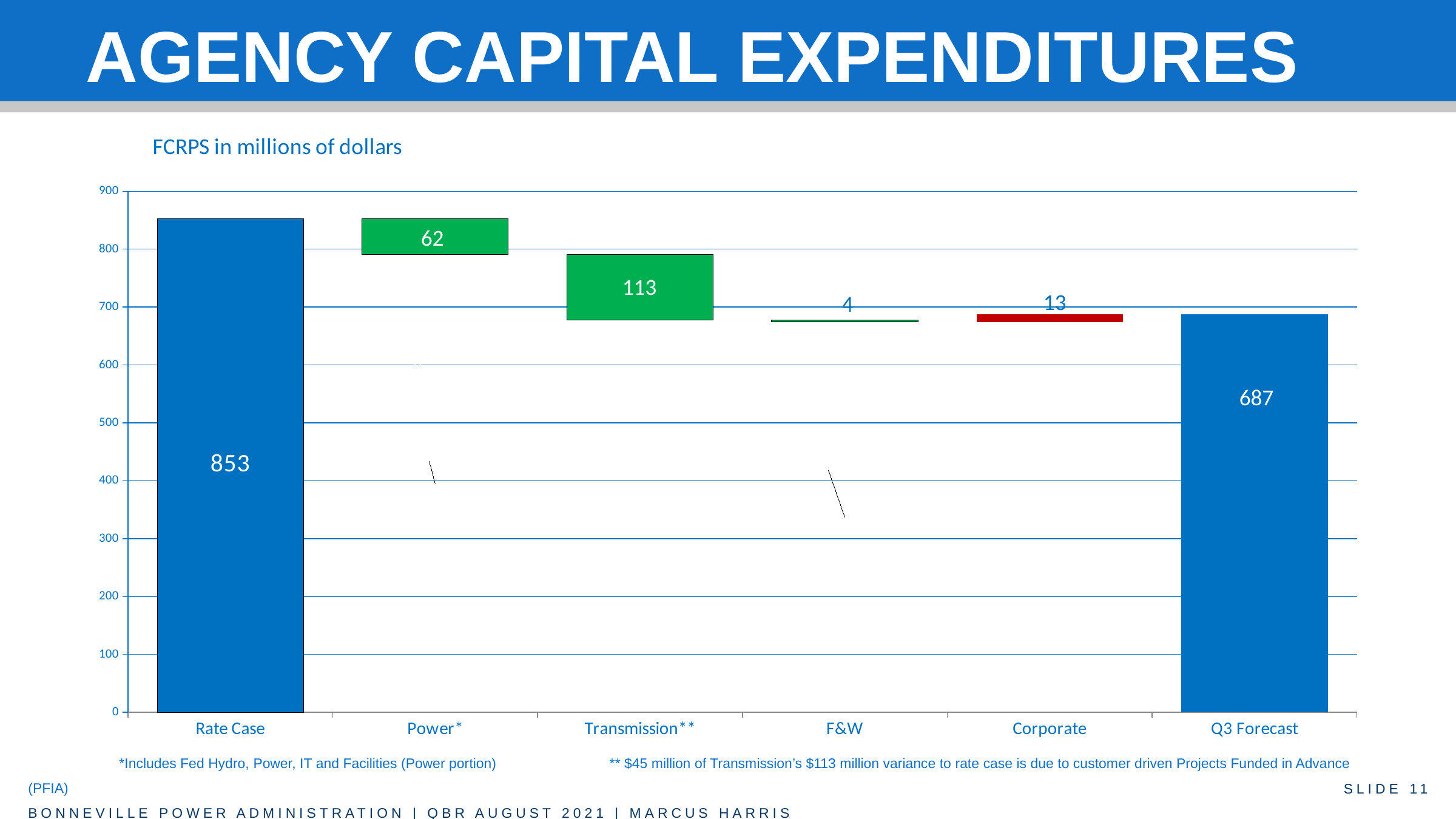
Which category has the highest value? Rate Case Which category has the lowest value? F&W What is the value for Rate Case? 853 What is the title of the chart? FCRPS in millions of dollars Is the value for Q3 Forecast greater or less than 700? less How many categories are shown on the x axis? 6 What is the value shown for Power*? 62 What is the value shown for Transmission**? 113 What is the difference between the Rate Case value and the Q3 Forecast value? 166 What is the value for Q3 Forecast? 687 Which is larger, the value for Transmission** or the value for Power*? Transmission** What is the value shown for Corporate? 13